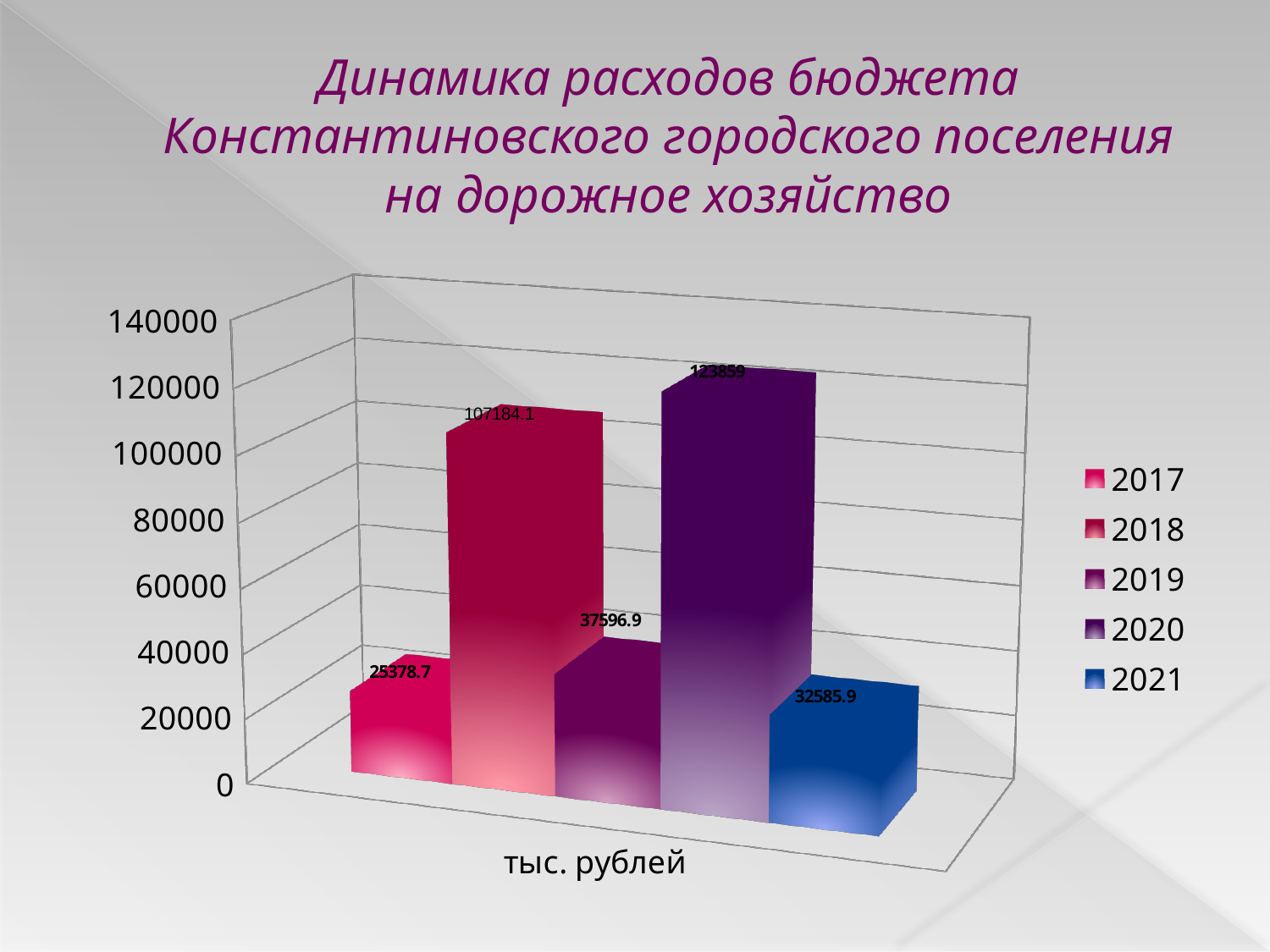
What is the value for 2020? 123859 Which year has the highest value? 2020 What is the value for 2018? 107184.1 What is the value for 2017? 25378.7 What is the value for 2021? 32585.9 Which is larger, the value for 2019 or the value for 2021? 2019 How many series does the legend list? 5 What kind of chart is shown on the slide? Bar chart Which year has the lowest value? 2017 What is the difference between the values for 2020 and 2018? 16674.9 What unit label is shown below the chart? тыс. рублей What is the value for 2019? 37596.9